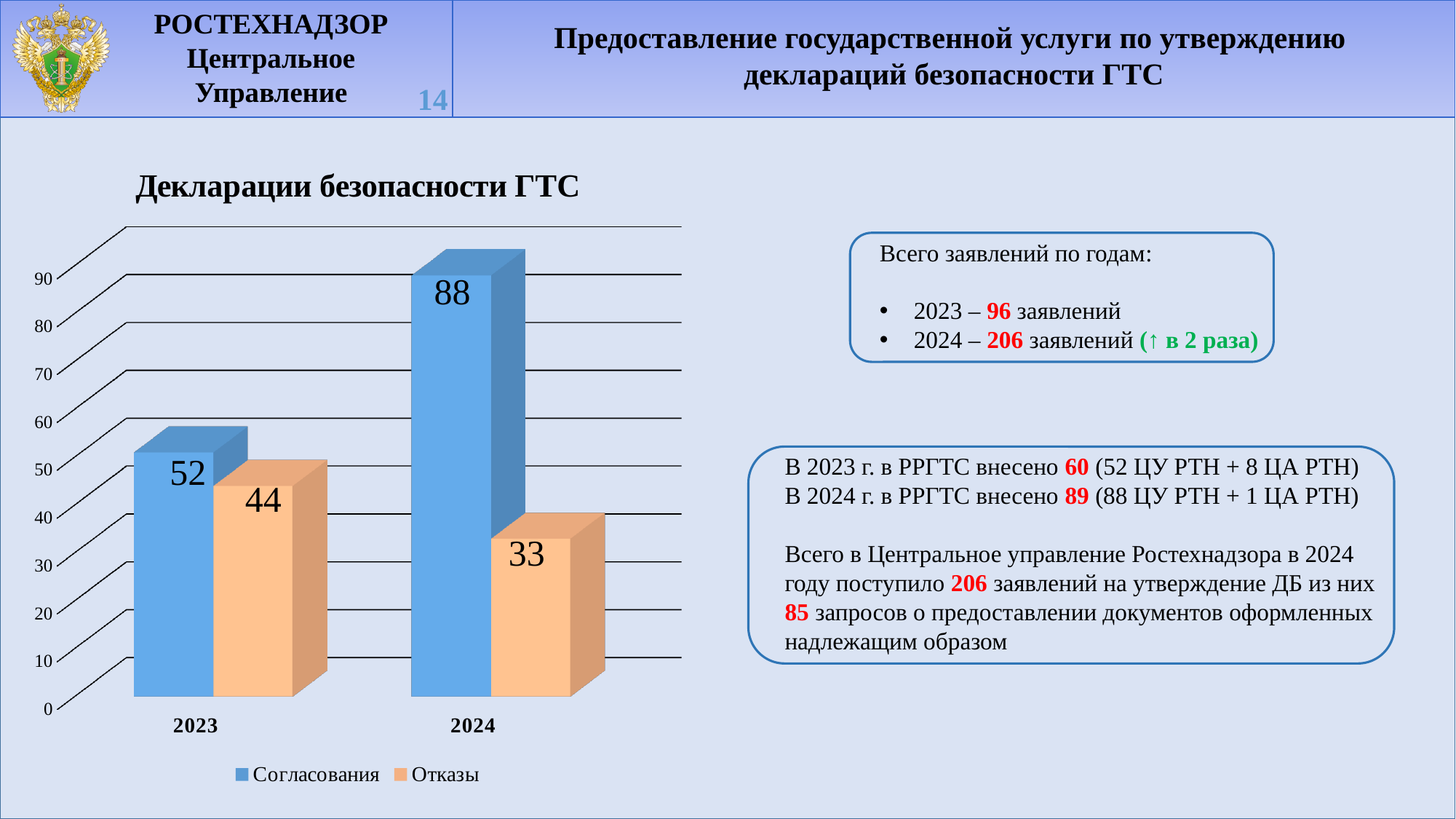
Which year has the highest value for Согласования? 2024 How many series does the legend list? 2 What is the title of the chart? Декларации безопасности ГТС What is the value for Отказы in 2023? 44 Which year has the lowest value for Отказы? 2024 What kind of chart is shown? bar chart How many years are shown on the x axis? 2 What is the value for Согласования in 2024? 88 Which is larger: Согласования in 2023 or Отказы in 2023? Согласования in 2023 What is the value for Отказы in 2024? 33 What is the value for Согласования in 2023? 52 What is the difference between Согласования in 2024 and Согласования in 2023? 36